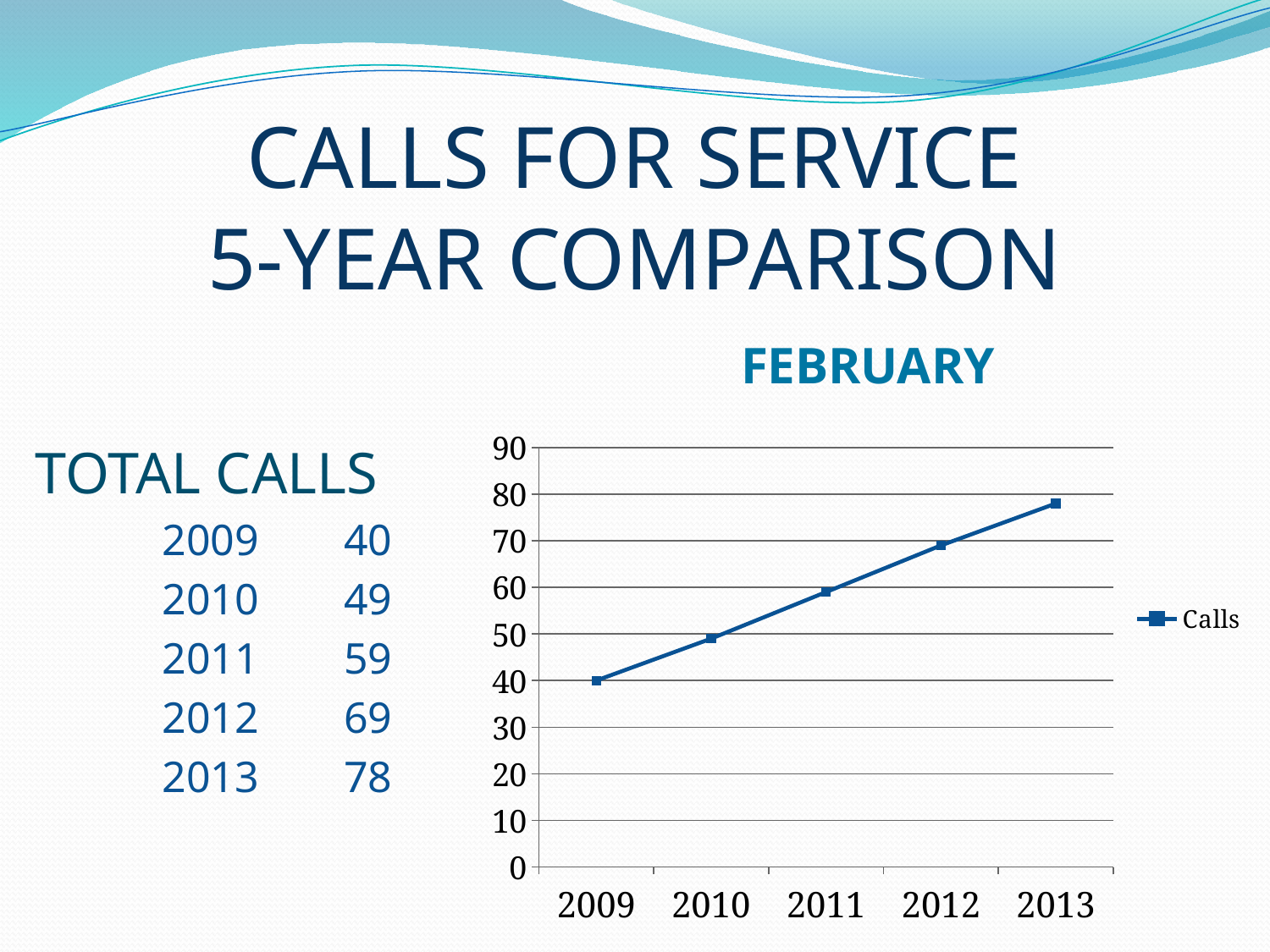
What is the number of calls for 2013? 78 Which year has the highest number of calls? 2013 What is the difference in calls between 2013 and 2009? 38 What is the difference in calls between 2012 and 2010? 20 What is the number of calls for 2011? 59 Do the calls rise or fall from 2009 to 2013? rise Which year has the lowest number of calls? 2009 Which year has more calls, 2010 or 2012? 2012 Is the value for 2012 greater or less than 60? greater What is the number of calls for 2009? 40 How many years are plotted on the x axis? 5 What type of chart is shown on the slide? line chart